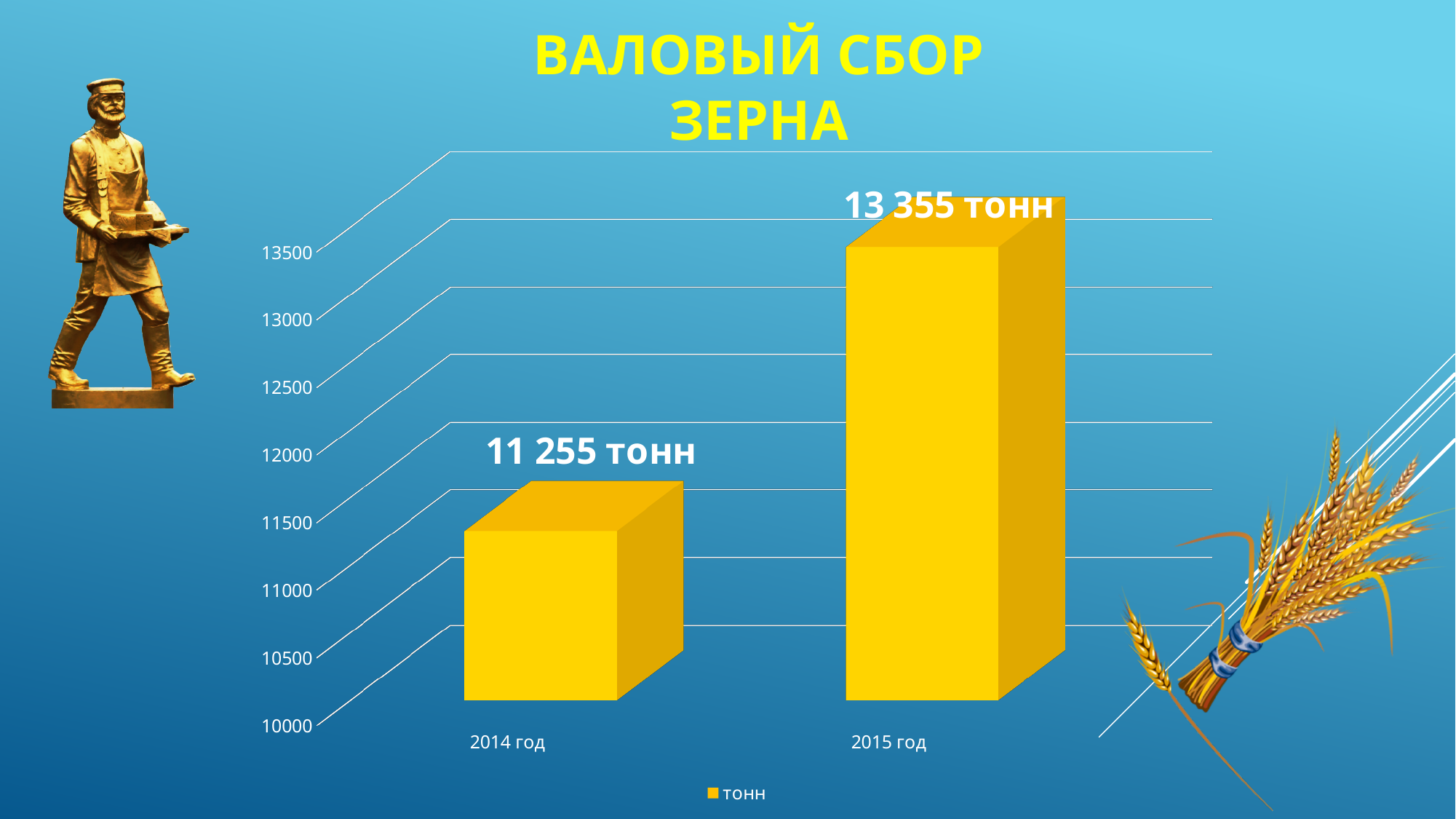
Which year has the highest value? 2015 год Is the value for 2014 год greater or less than 11500? less What is the value for 2014 год? 11 255 тонн Which year has the lowest value? 2014 год How many series does the legend list? 1 What kind of chart is shown? bar chart How many categories are shown on the chart? 2 Is the value for 2015 год greater or less than 13000? greater What is the difference between the values for 2015 год and 2014 год? 2 100 тонн Which is larger, the value for 2014 год or 2015 год? 2015 год What is the title of the chart? ВАЛОВЫЙ СБОР ЗЕРНА What is the value for 2015 год? 13 355 тонн